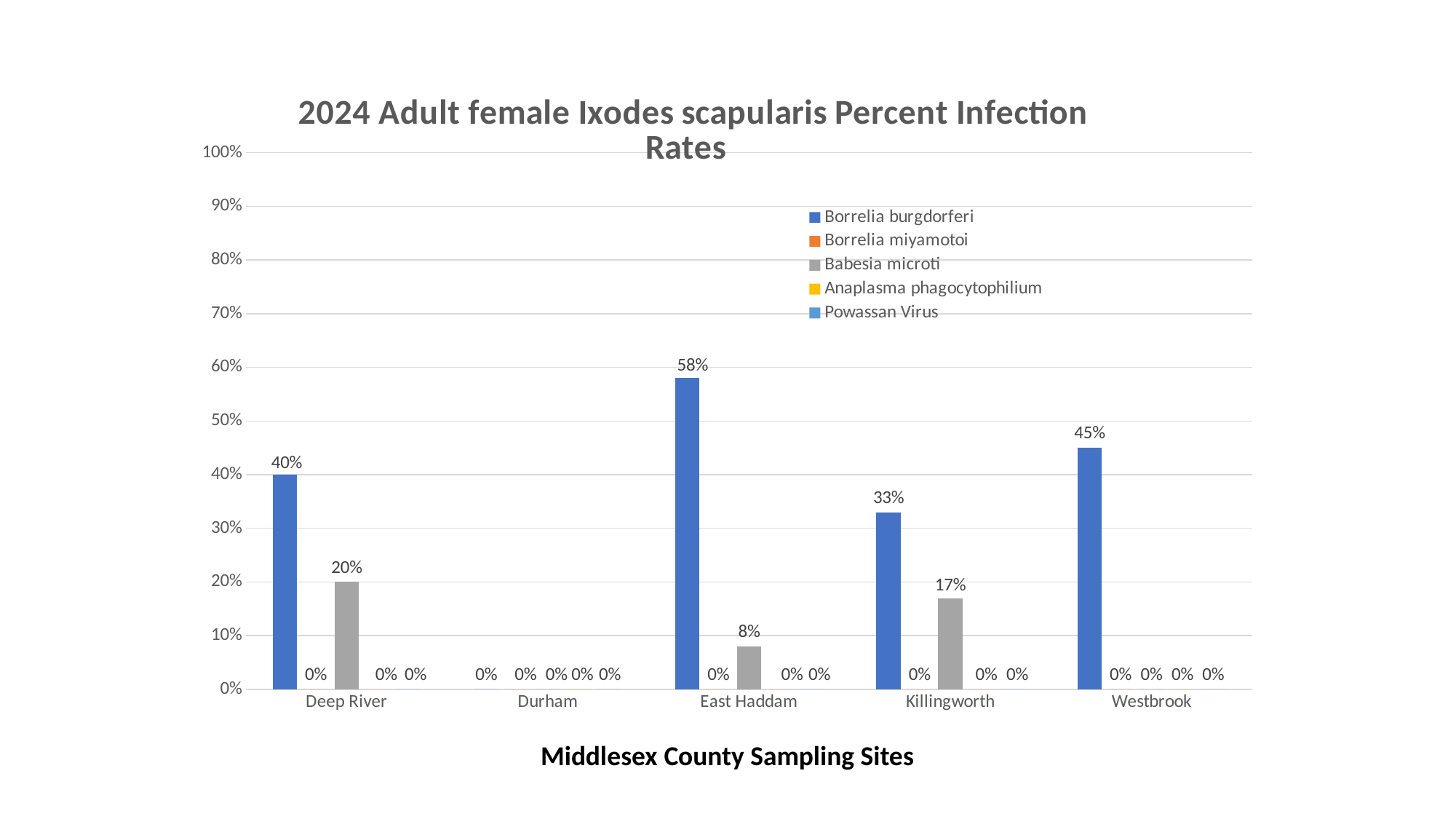
What is the Borrelia burgdorferi infection rate at Westbrook? 45% What is the Babesia microti infection rate at Killingworth? 17% What is the Borrelia burgdorferi infection rate at East Haddam? 58% How many series does the legend list? 5 Which sampling site has the lowest Borrelia burgdorferi infection rate? Durham What is the Babesia microti infection rate at Deep River? 20% Which is larger, the Babesia microti rate at Deep River or at Killingworth? Deep River What kind of chart is shown on the slide? Bar chart Which sampling site has the highest Borrelia burgdorferi infection rate? East Haddam What is the x-axis title of the chart? Middlesex County Sampling Sites How many sampling sites are shown on the x axis? 5 What is the difference between the Borrelia burgdorferi infection rates at East Haddam and Deep River? 18%